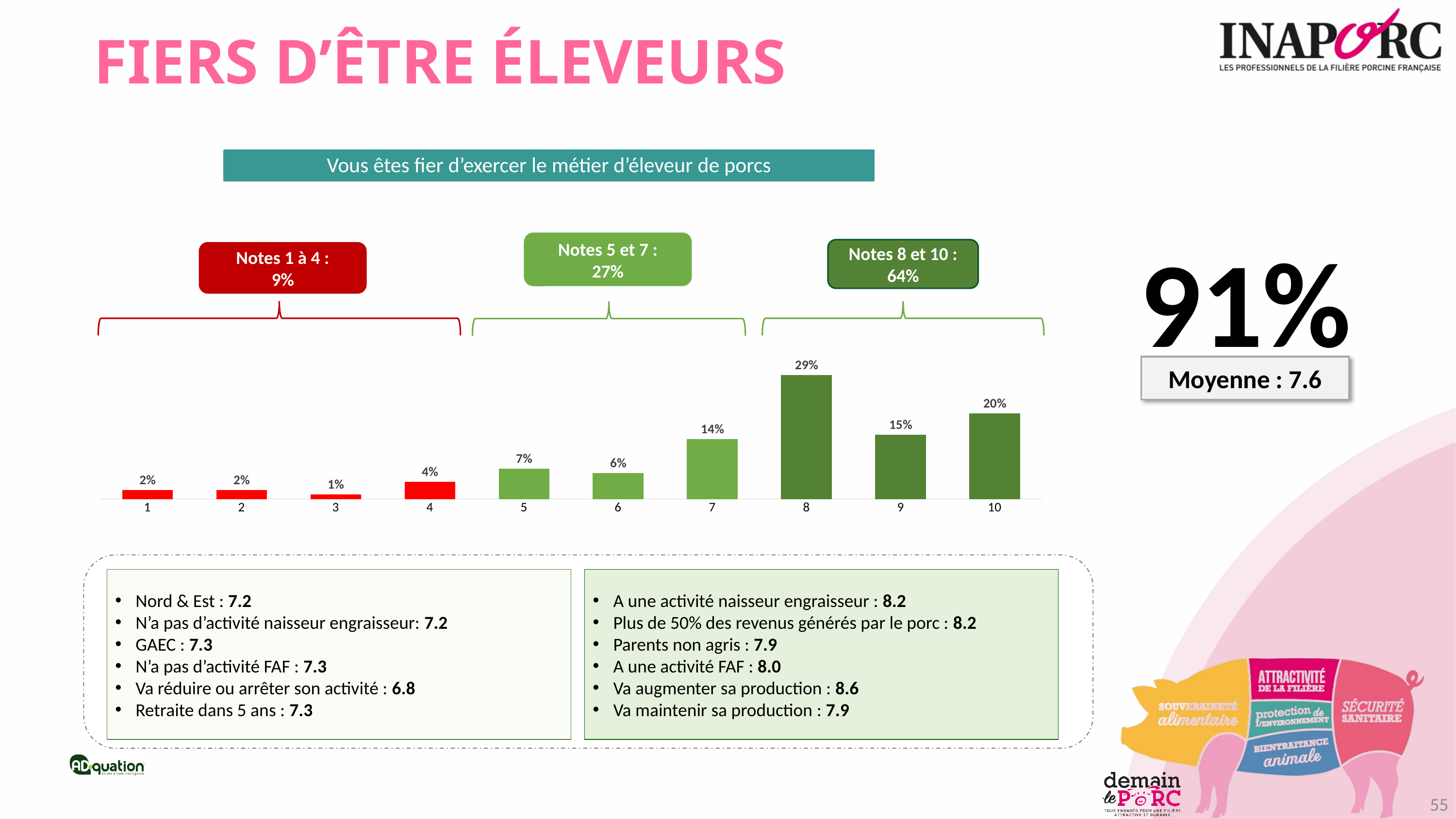
Which has a larger share of respondents, score 7 or score 10? 10 What type of chart is used to show the distribution of scores? bar chart How many score categories are shown on the x axis of the chart? 10 What is the combined percentage for scores 5, 6 and 7 according to the label above the bracket? 27% What is the average score (Moyenne) shown on the slide? 7.6 Which score has the highest percentage of respondents? 8 What colour are the bars for scores 1 to 4? red Which score has the lowest percentage of respondents? 3 What percentage of respondents gave a score of 3? 1% What percentage of respondents gave a score of 10? 20% What percentage of respondents gave a score of 8? 29% What is the difference in percentage points between score 8 and score 9? 14